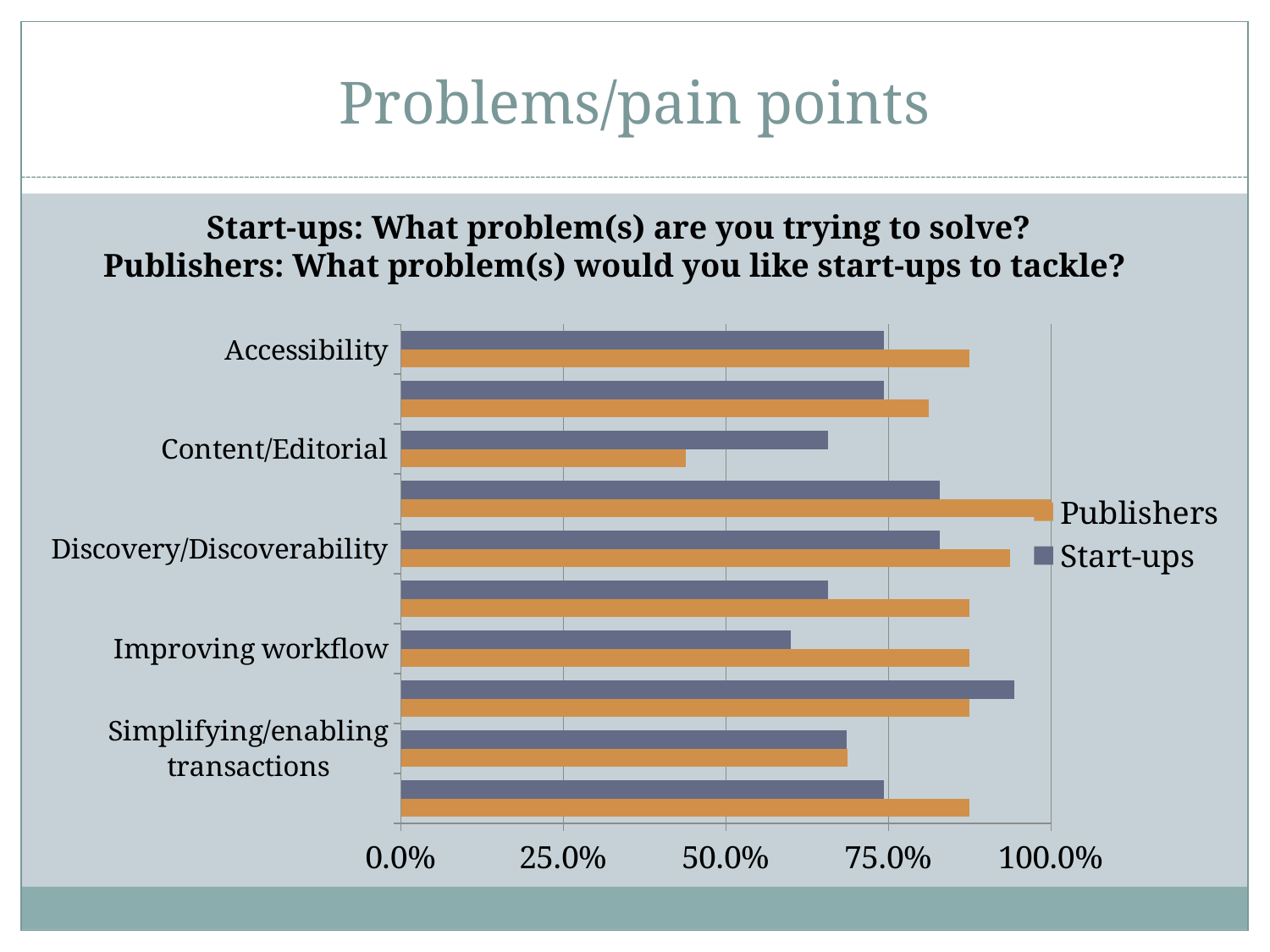
Is the Start-ups value for Improving workflow greater or less than 75.0%? less What kind of chart is shown on the slide? bar chart Is the Publishers value for Accessibility greater or less than 75.0%? greater Is the Publishers value for Content/Editorial greater or less than 50.0%? less Which two series are listed in the legend? Publishers and Start-ups How many series does the legend list? 2 What colour are the Publishers bars? orange For Content/Editorial, which series has the larger value, Publishers or Start-ups? Start-ups For Improving workflow, which series has the larger value, Publishers or Start-ups? Publishers For Accessibility, which series has the larger value, Publishers or Start-ups? Publishers